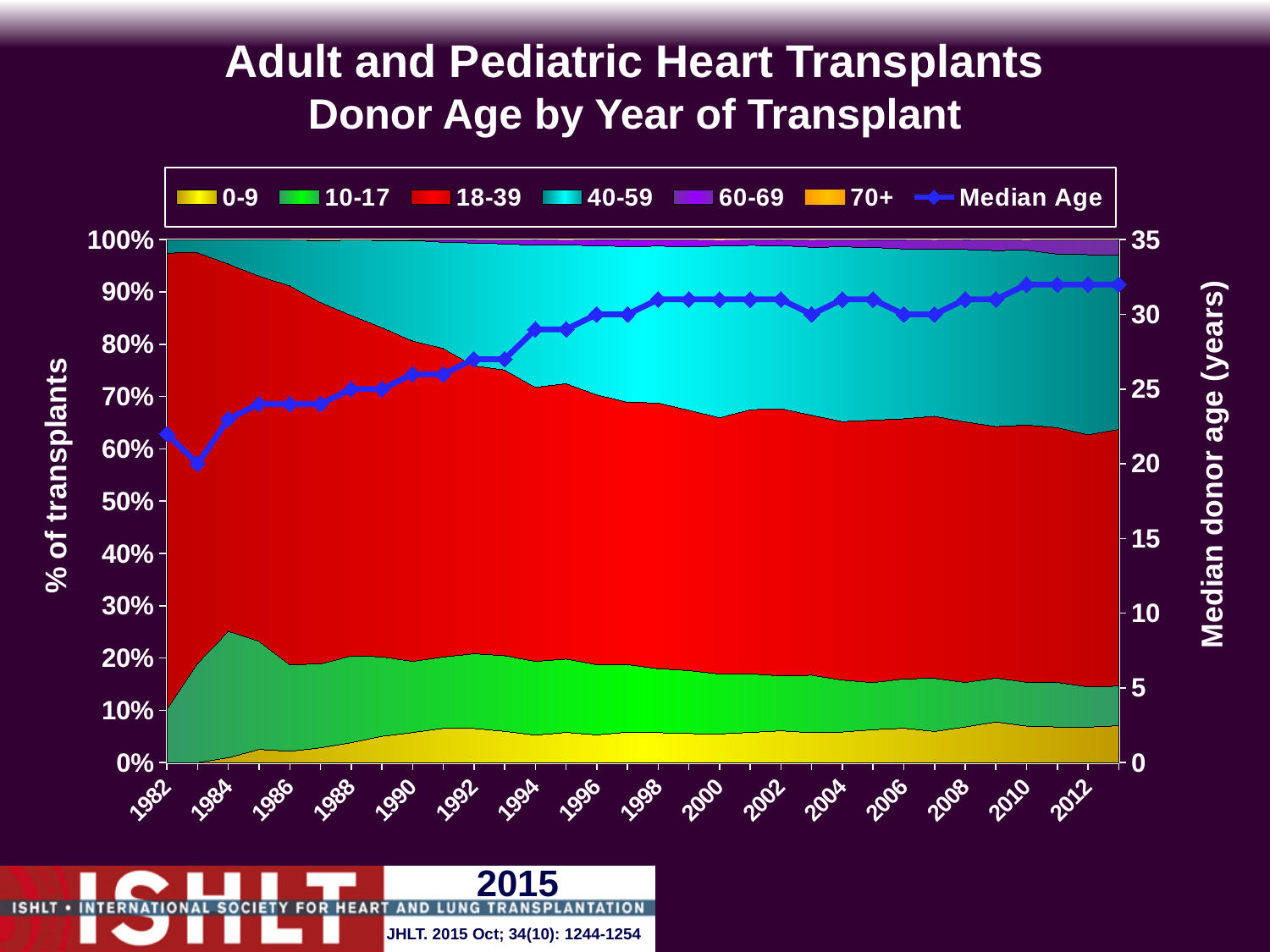
Is the Median Age value for 1990 greater or less than 30? less Which donor age group makes up the largest share of transplants in 2012? 18-39 What kind of chart is this? Stacked area chart with a line Is the Median Age value for 2012 greater or less than 30? greater Is the Median Age value for 1983 greater or less than 25? less Does the Median Age line rise or fall from 1982 to 2012? Rise What is the label of the left vertical axis? % of transplants How many year labels are shown on the x axis? 16 What is the title of the chart? Adult and Pediatric Heart Transplants Donor Age by Year of Transplant How many series does the legend list? 7